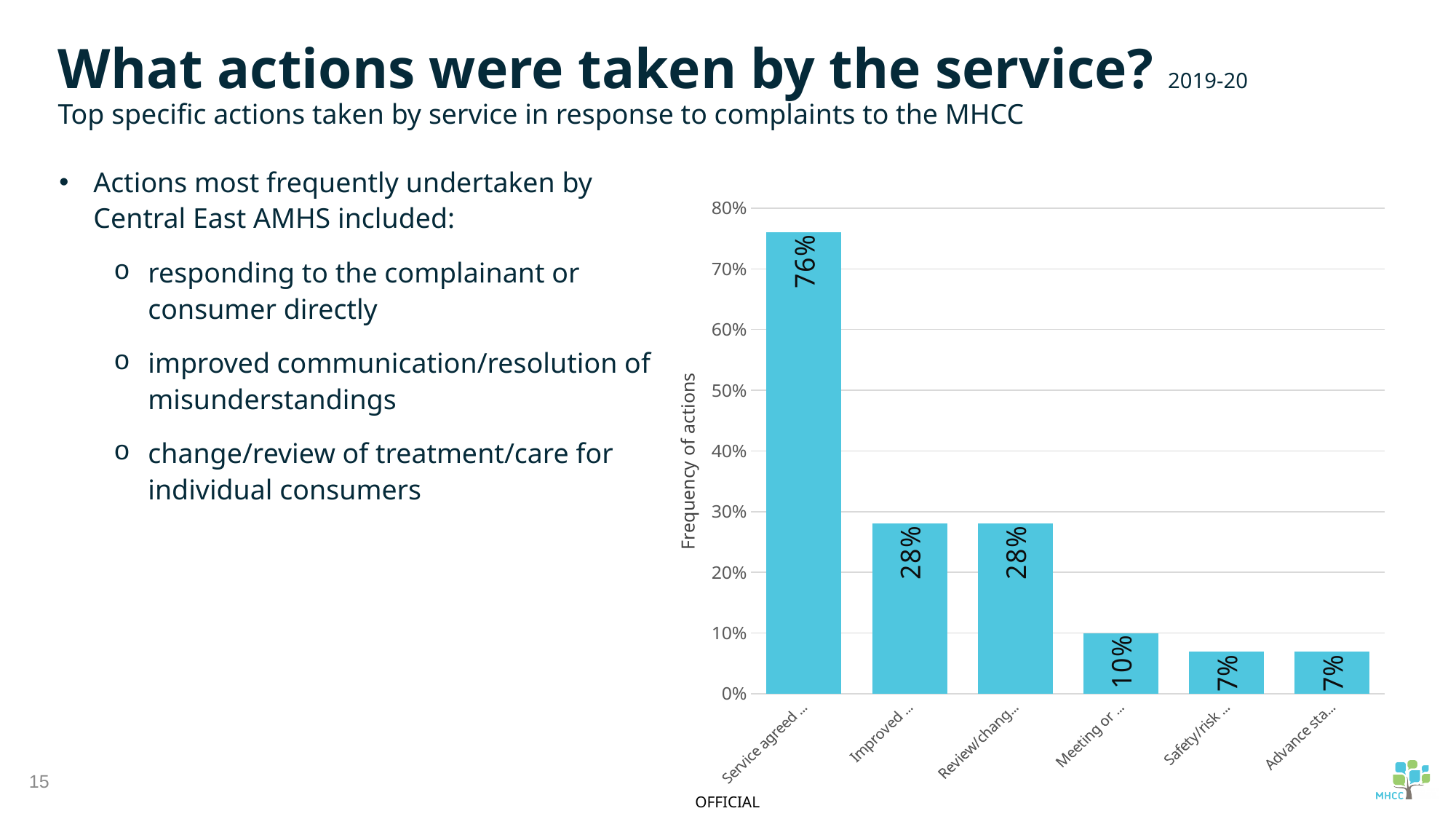
What is the value of the bar labelled "Safety/risk ..."? 7% What is the difference between the "Meeting or ..." bar and the "Advance sta..." bar? 3% Which category has the highest frequency of actions? Service agreed ... What is the value of the bar labelled "Service agreed ..."? 76% What is the label of the vertical axis of the chart? Frequency of actions What is the difference between the "Service agreed ..." bar and the "Improved ..." bar? 48% Which is larger, the value for "Review/chang..." or the value for "Meeting or ..."? Review/chang... How many bars are shown in the chart? 6 What is the value of the bar labelled "Meeting or ..."? 10% What type of chart is shown on the slide? Bar chart Is the value for "Service agreed ..." greater or less than 70%? greater What is the value of the bar labelled "Improved ..."? 28%